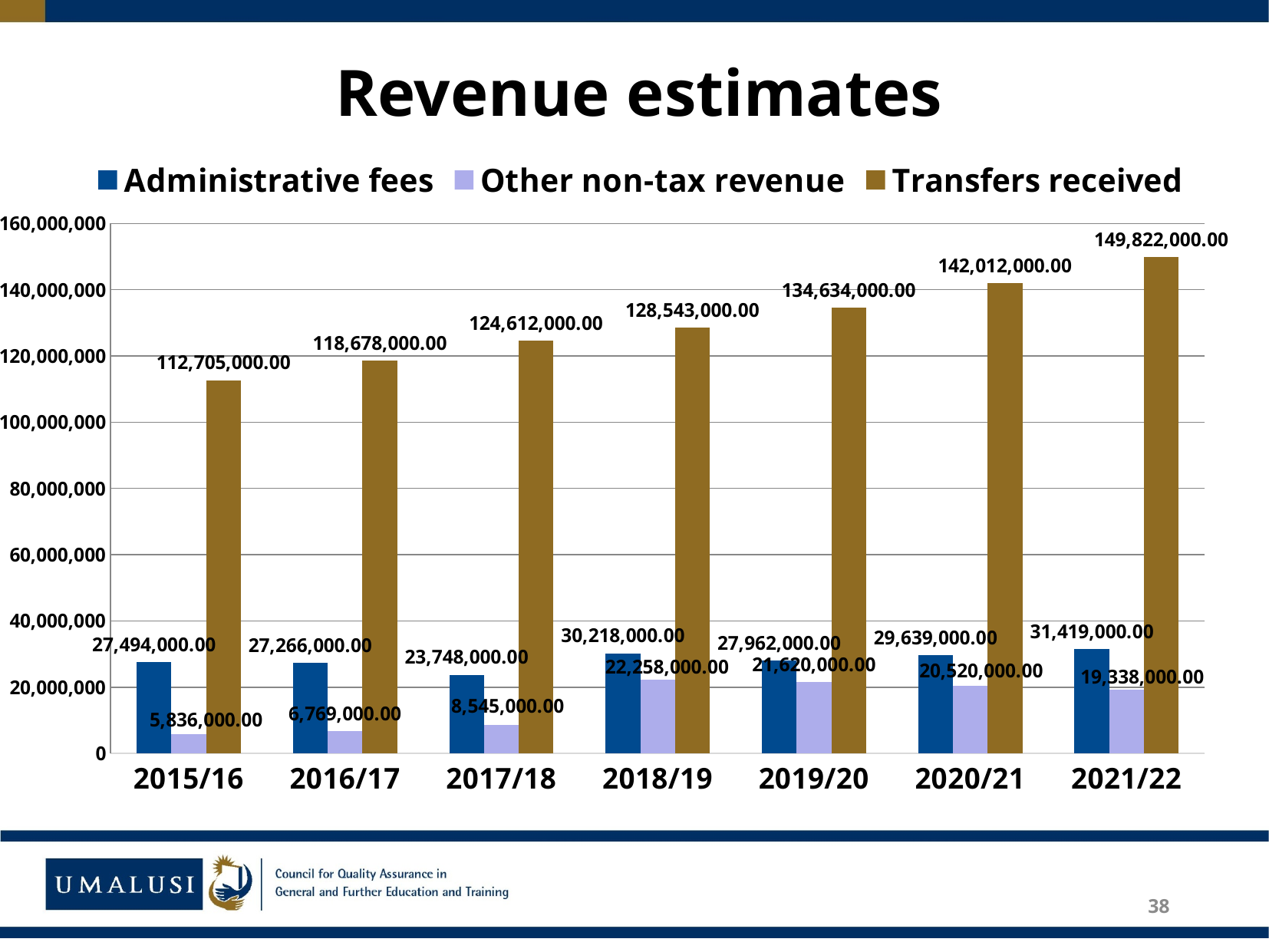
In which year is Transfers received the highest? 2021/22 What is the value of Transfers received for 2015/16? 112,705,000.00 What kind of chart is shown on the slide? Bar chart How many years are shown on the x axis? 7 Which is larger: Administrative fees in 2016/17 or in 2019/20? 2019/20 How many series does the legend list? 3 What is the value of Administrative fees for 2018/19? 30,218,000.00 In which year is Administrative fees the highest? 2021/22 In which year is Other non-tax revenue the lowest? 2015/16 Do the values for Transfers received rise or fall from 2015/16 to 2021/22? Rise What is the value of Other non-tax revenue for 2017/18? 8,545,000.00 What is the difference between Transfers received in 2021/22 and in 2015/16? 37,117,000.00